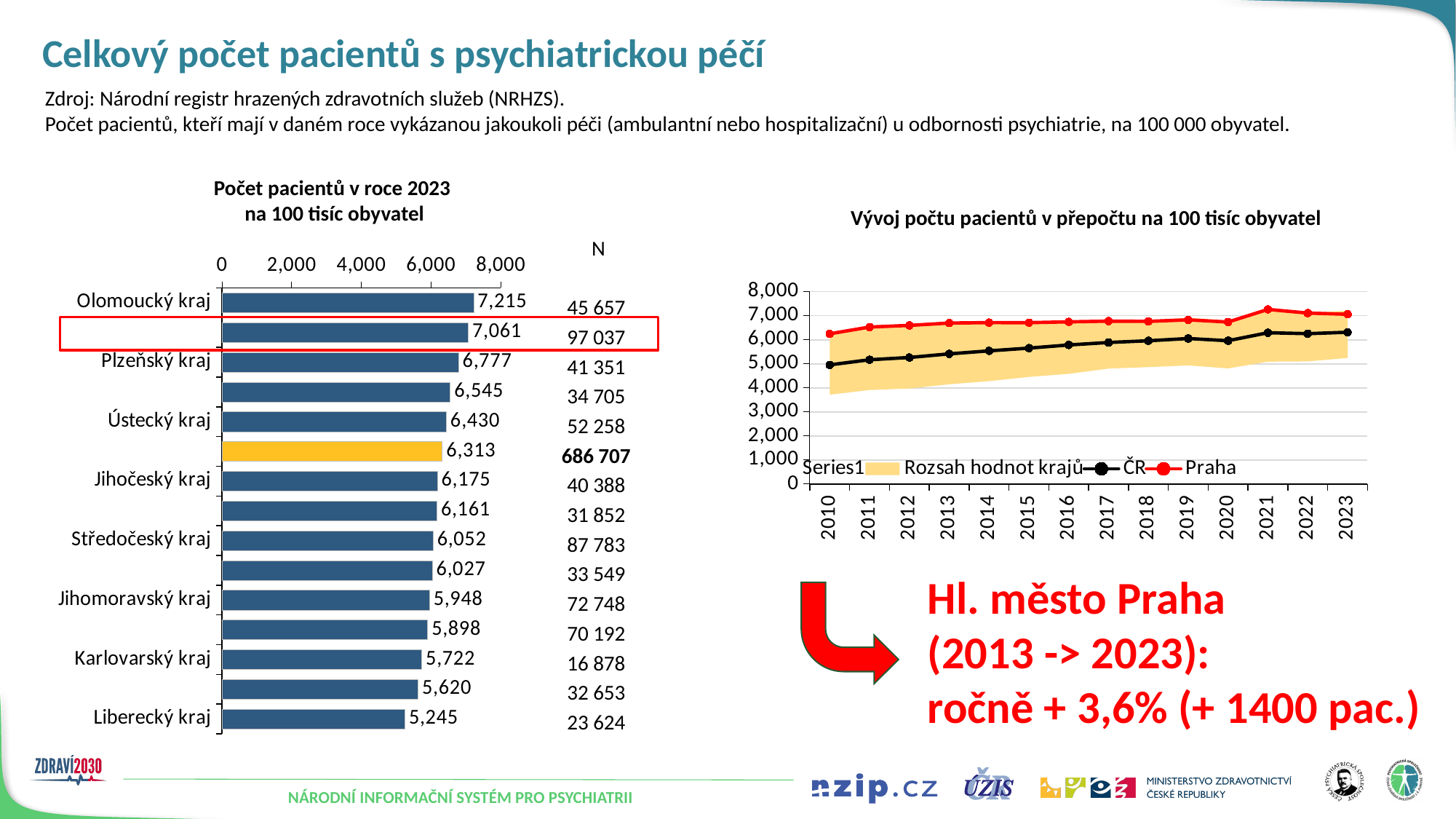
What kind of chart is 'Počet pacientů v roce 2023 na 100 tisíc obyvatel'? Bar chart In the bar chart 'Počet pacientů v roce 2023 na 100 tisíc obyvatel', which region has the lowest value? Liberecký kraj In the bar chart 'Počet pacientů v roce 2023 na 100 tisíc obyvatel', what is the value for Středočeský kraj? 6,052 In the bar chart 'Počet pacientů v roce 2023 na 100 tisíc obyvatel', which is larger, Plzeňský kraj or Jihočeský kraj? Plzeňský kraj In the chart 'Vývoj počtu pacientů v přepočtu na 100 tisíc obyvatel', does the ČR line rise or fall from 2010 to 2023? rise In the bar chart 'Počet pacientů v roce 2023 na 100 tisíc obyvatel', which region has the highest value? Olomoucký kraj In the bar chart 'Počet pacientů v roce 2023 na 100 tisíc obyvatel', what is the value for Liberecký kraj? 5,245 How many bars are shown in the bar chart 'Počet pacientů v roce 2023 na 100 tisíc obyvatel'? 15 In the bar chart 'Počet pacientů v roce 2023 na 100 tisíc obyvatel', what is the value for Olomoucký kraj? 7,215 In the chart 'Vývoj počtu pacientů v přepočtu na 100 tisíc obyvatel', is the value for Praha in 2023 greater or less than 6,000? greater How many entries does the legend of the chart 'Vývoj počtu pacientů v přepočtu na 100 tisíc obyvatel' list? 4 In the bar chart 'Počet pacientů v roce 2023 na 100 tisíc obyvatel', what is the difference between Olomoucký kraj and Liberecký kraj? 1,970